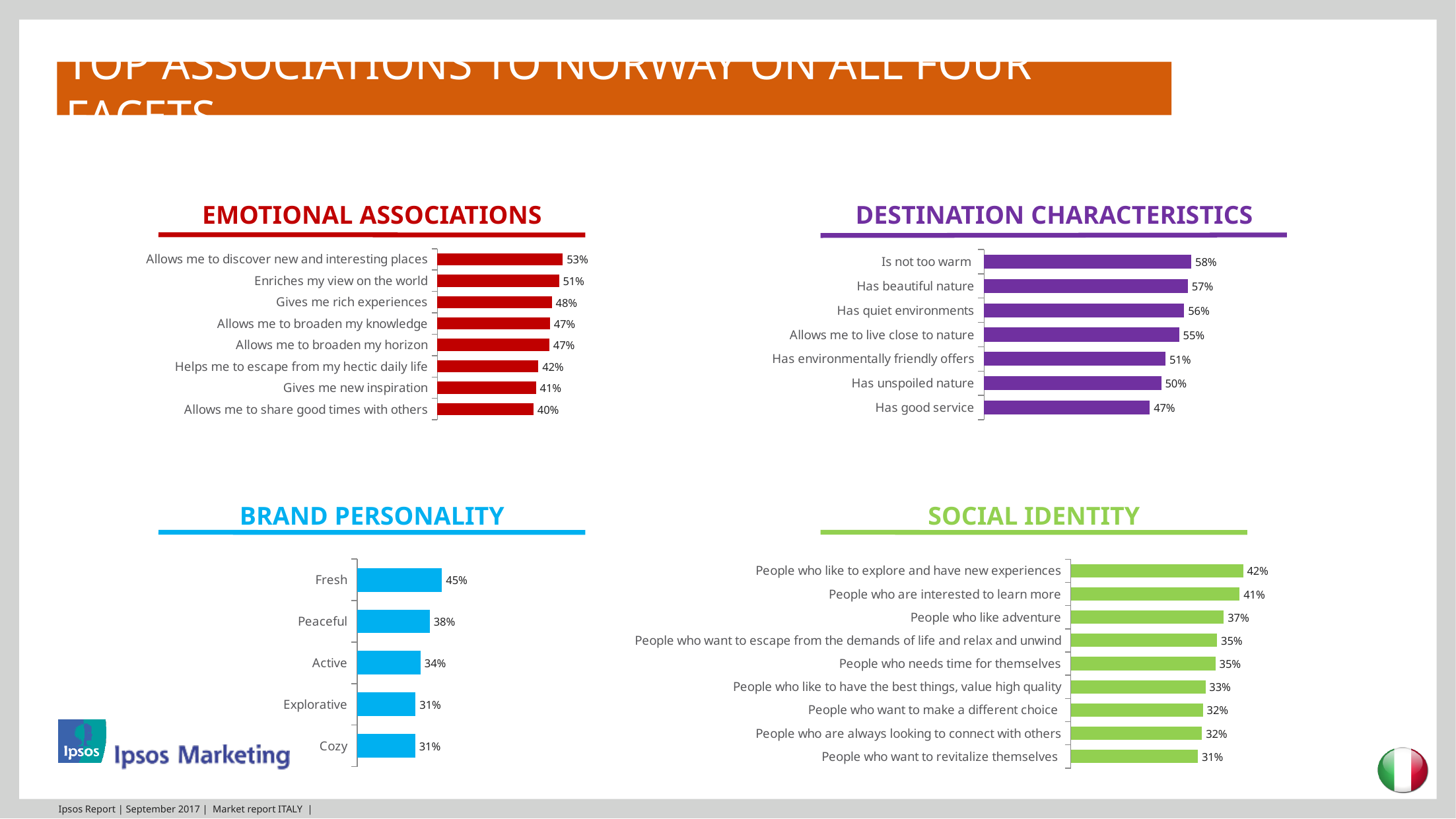
How many categories are shown in the Social Identity chart? 9 In the Destination Characteristics chart, which category has the highest value? Is not too warm In the Destination Characteristics chart, what is the difference between "Is not too warm" and "Has good service"? 11% In the Emotional Associations chart, which category has the lowest value? Allows me to share good times with others In the Social Identity chart, which is larger: "People who are interested to learn more" or "People who want to revitalize themselves"? People who are interested to learn more How many categories are shown in the Brand Personality chart? 5 In the Brand Personality chart, what is the difference between "Fresh" and "Active"? 11% In the Social Identity chart, what is the value for "People who like adventure"? 37% What type of chart is the Emotional Associations chart? Bar chart In the Brand Personality chart, what is the value for "Peaceful"? 38% In the Emotional Associations chart, what is the value for "Enriches my view on the world"? 51% In the Destination Characteristics chart, what is the value for "Has unspoiled nature"? 50%